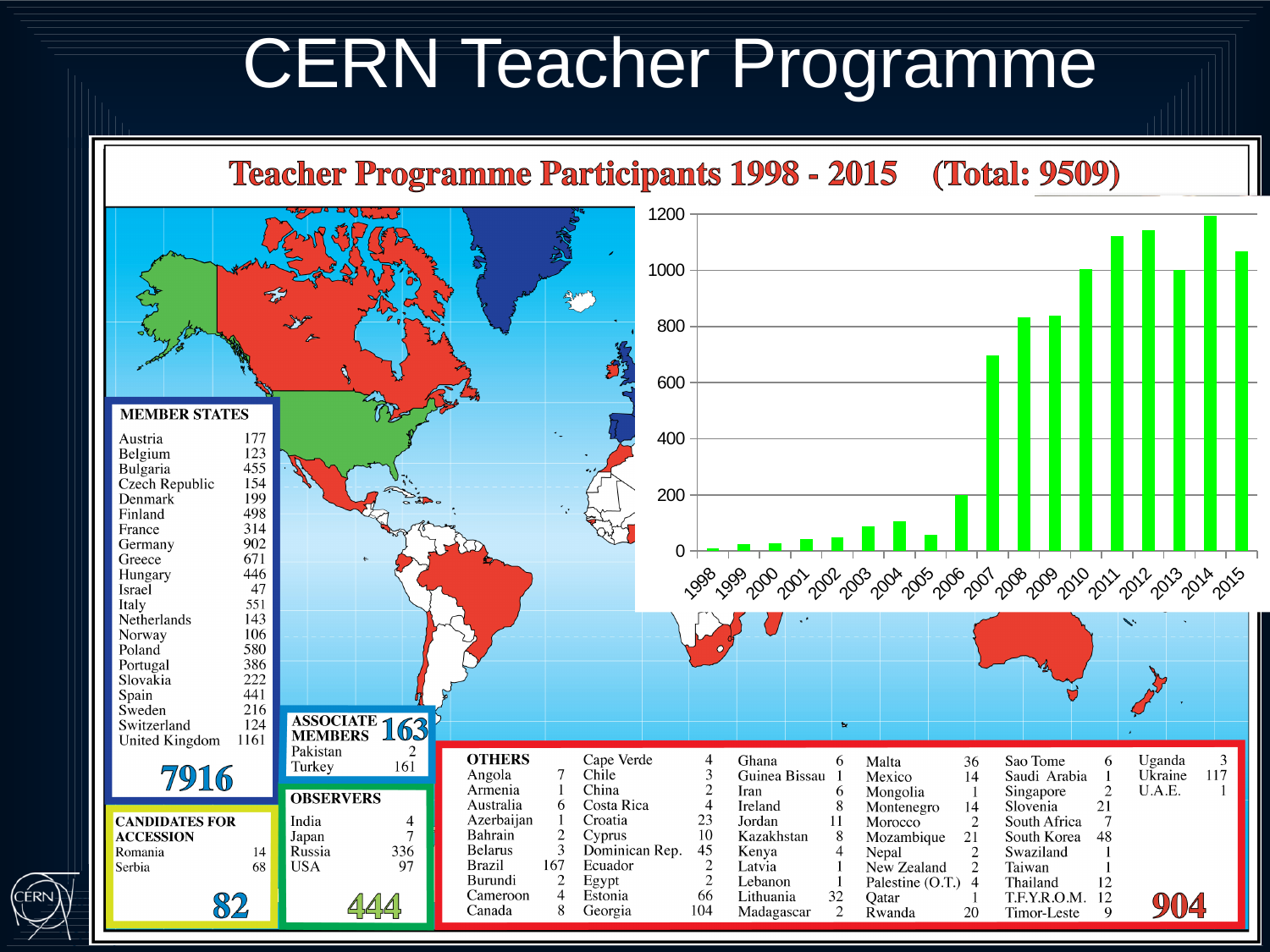
Is the value for 2007 greater or less than 600? greater Do the participant numbers generally rise or fall from 1998 to 2015? rise Is the value for 2003 greater or less than 200? less Which year has the lowest number of participants? 1998 Which year has the highest number of participants? 2014 Which year has more participants, 2004 or 2005? 2004 How many years are plotted on the x axis of the chart? 18 Is the value for 2009 greater or less than 800? greater What kind of chart is shown on the slide? bar chart What is the title of the chart? Teacher Programme Participants 1998 - 2015 (Total: 9509) Which year has more participants, 2007 or 2008? 2008